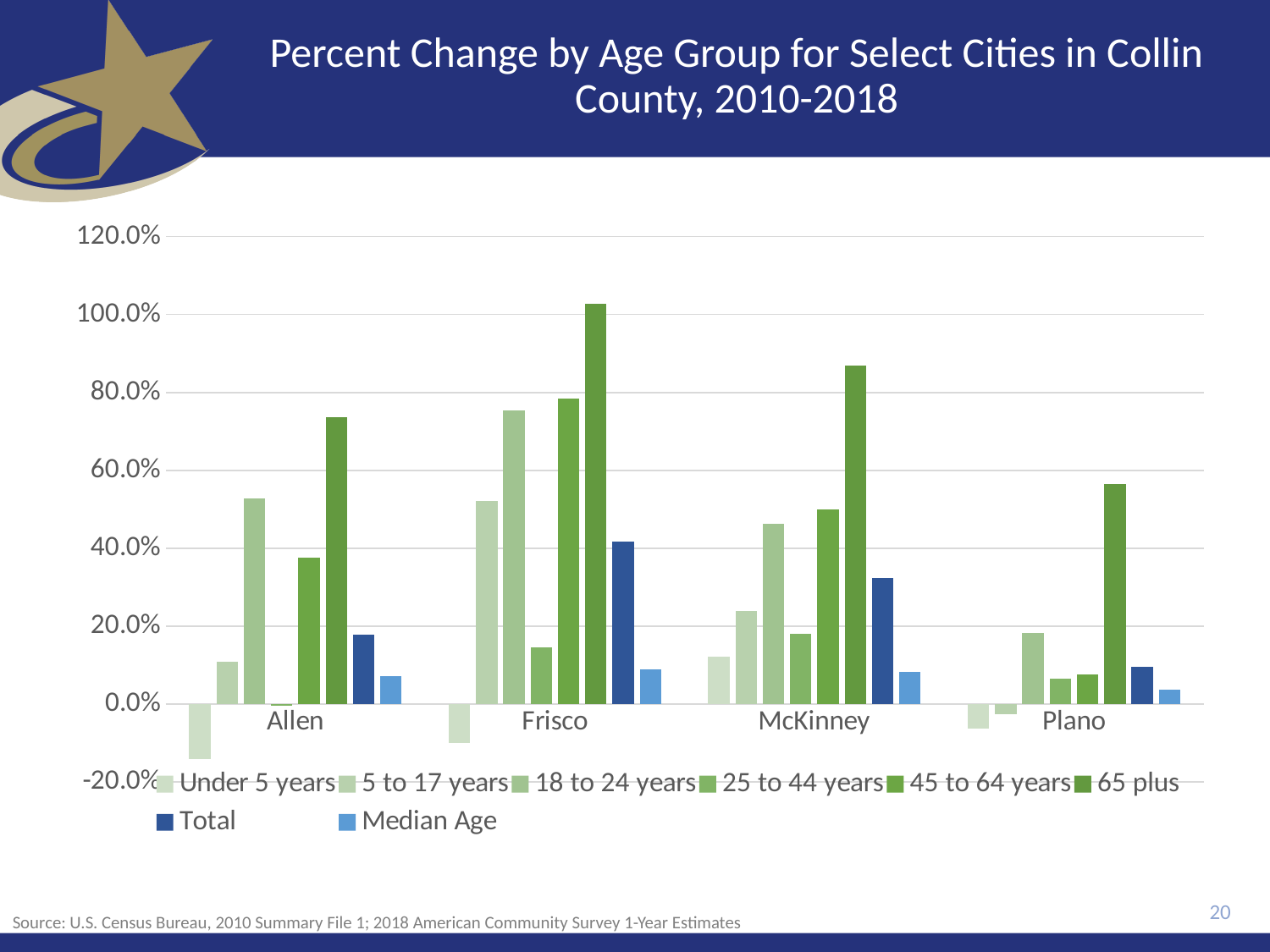
Is the Under 5 years value for Allen greater or less than 0.0%? less How many cities are shown on the x axis? 4 How many series does the legend list? 8 Is the 65 plus value for Frisco greater or less than 100.0%? greater Which city has the highest value for the 65 plus series? Frisco Which is larger, the Total value for Frisco or the Total value for McKinney? Frisco Which is larger, the 18 to 24 years value for Allen or for McKinney? Allen Is the Total value for McKinney greater or less than 40.0%? less Which city has the lowest value for the 65 plus series? Plano What kind of chart is shown on the slide? Bar chart Which city has the lowest Total value? Plano What is the title of the chart? Percent Change by Age Group for Select Cities in Collin County, 2010-2018